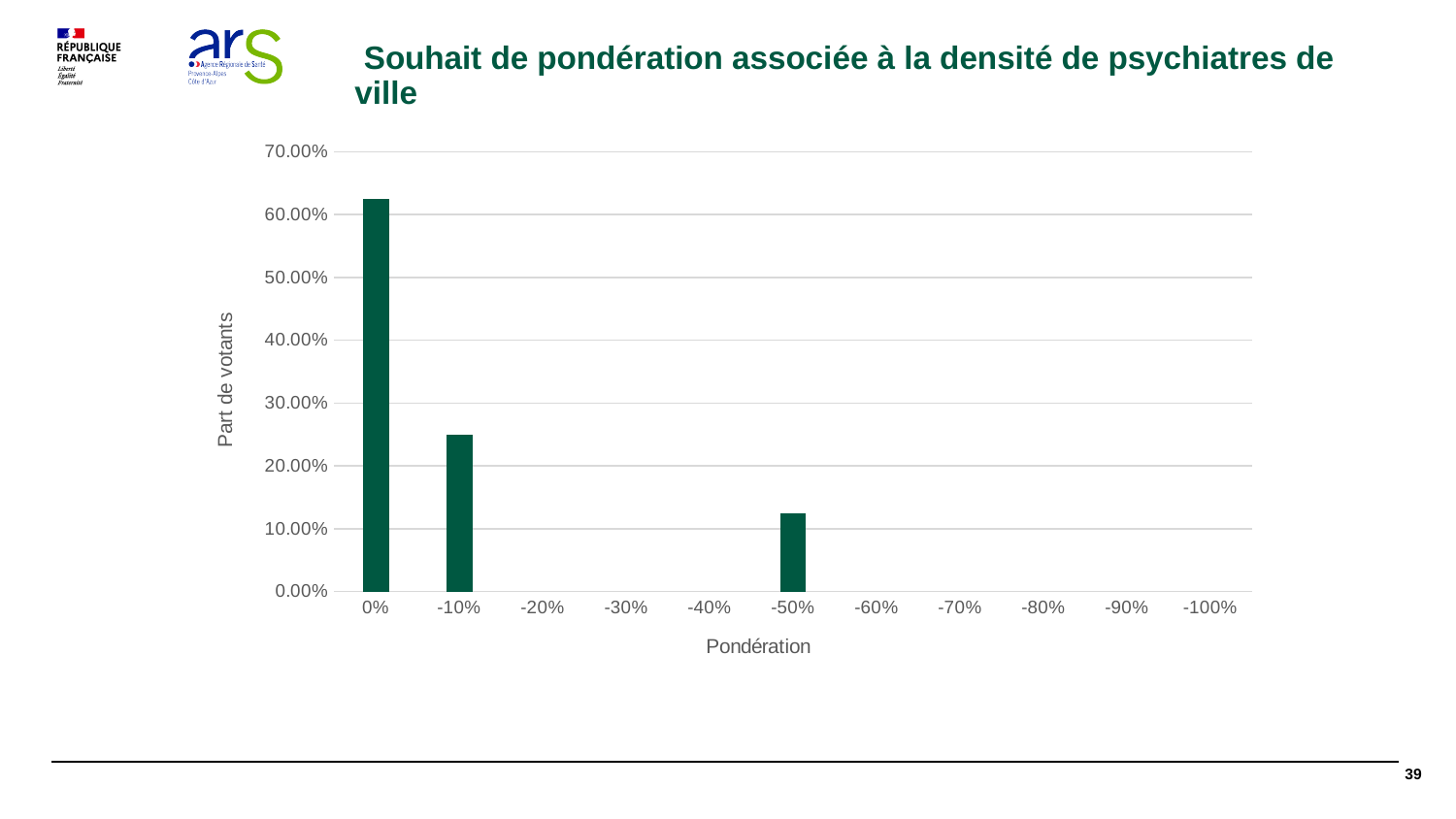
How many categories are shown on the x axis? 11 Which is larger, the value for 0% or the value for -10%? 0% What is the label of the y axis? Part de votants Which is larger, the value for -10% or the value for -50%? -10% What kind of chart is shown on the slide? bar chart Is the value for -50% greater or less than 20.00%? less What is the label of the x axis? Pondération Is the value for 0% greater or less than 60.00%? greater Is the value for -50% greater or less than 10.00%? greater Which pondération category has the highest share of voters? 0%